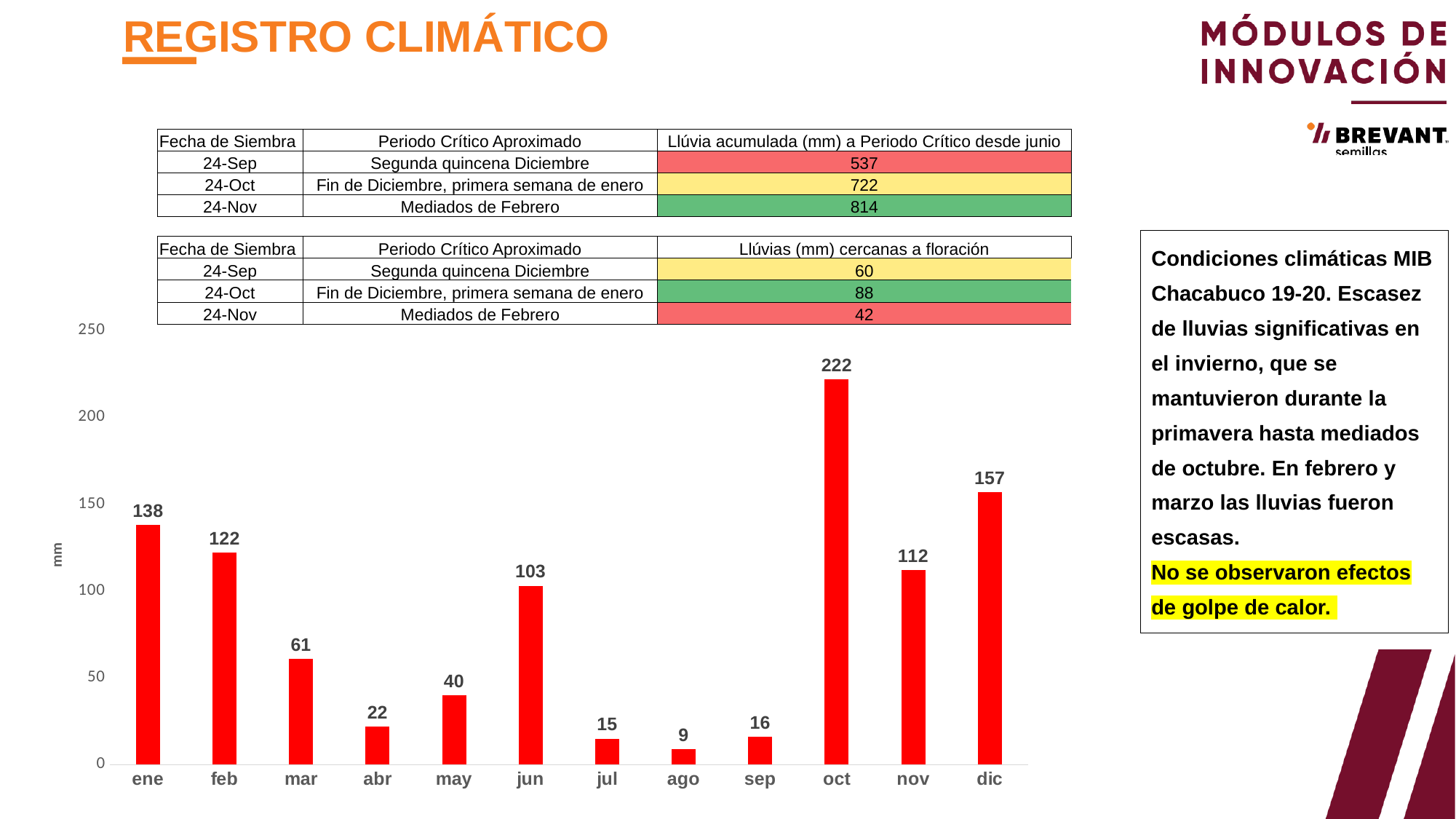
What is the difference between the values for dic and nov in the bar chart? 45 Which month has the highest value in the bar chart? oct Which month has the lowest value in the bar chart? ago What is the label on the vertical axis of the bar chart? mm What is the value for jun in the bar chart? 103 Do the values in the bar chart rise or fall from jun to ago? fall What kind of chart is shown on the slide? bar chart What is the value for oct in the bar chart? 222 How many months are shown on the x axis of the bar chart? 12 Which is larger in the bar chart, the value for ene or the value for feb? ene Is the value for oct in the bar chart greater or less than 200? greater What colour are the bars in the bar chart? red